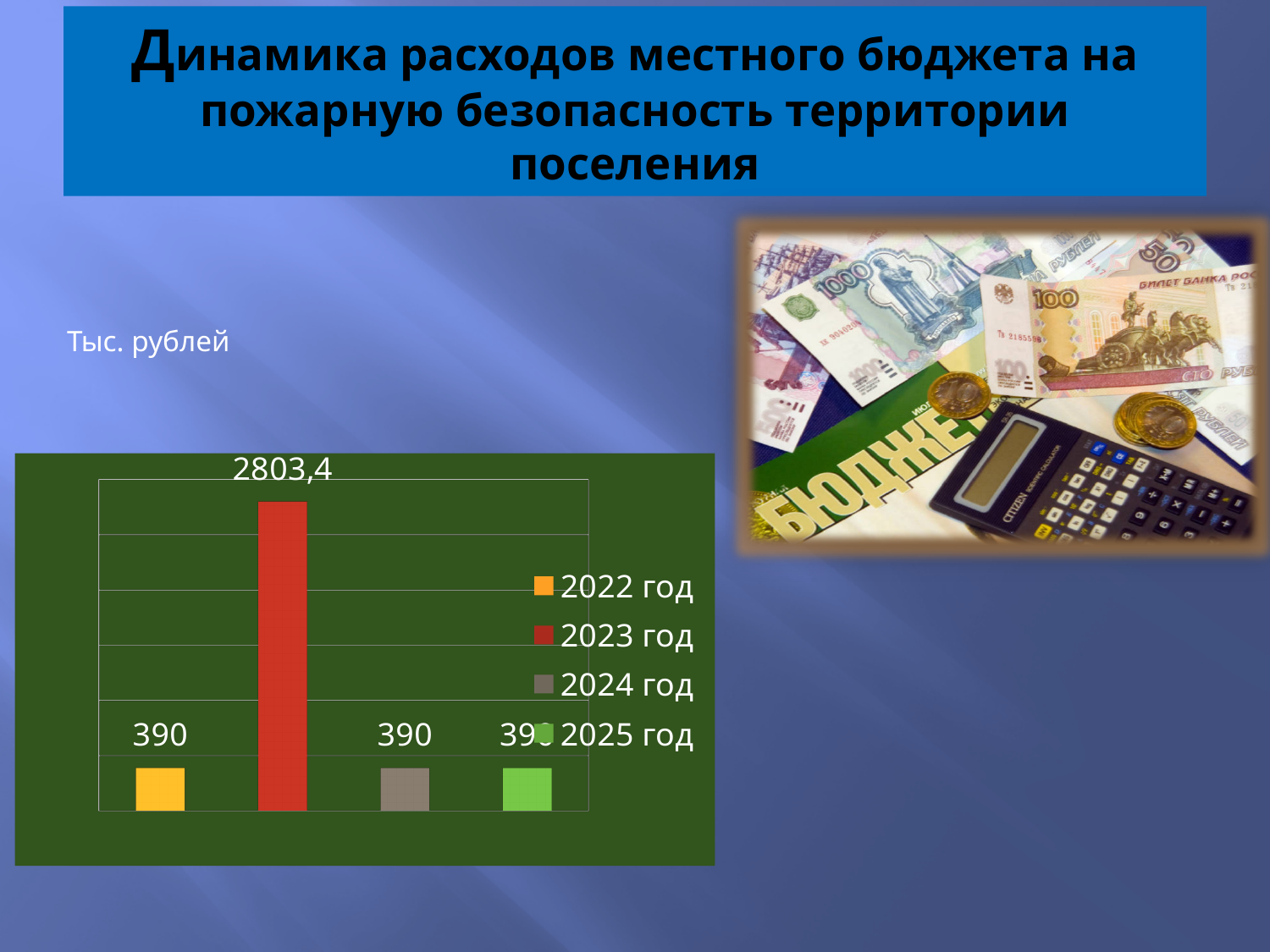
What is the value for 2024 год? 390 What is the difference between the value for 2023 год and the value for 2022 год? 2413,4 What unit is stated for the chart values? Тыс. рублей What is the value for 2023 год? 2803,4 How many bars are plotted in the chart? 4 How many series does the legend list? 4 Which year has the highest value? 2023 год Are the values for 2022 год and 2024 год equal? Yes Which is larger, the value for 2023 год or the value for 2022 год? 2023 год What kind of chart is shown on the slide? Bar chart What is the value for 2022 год? 390 What colour is the bar for 2023 год? Red